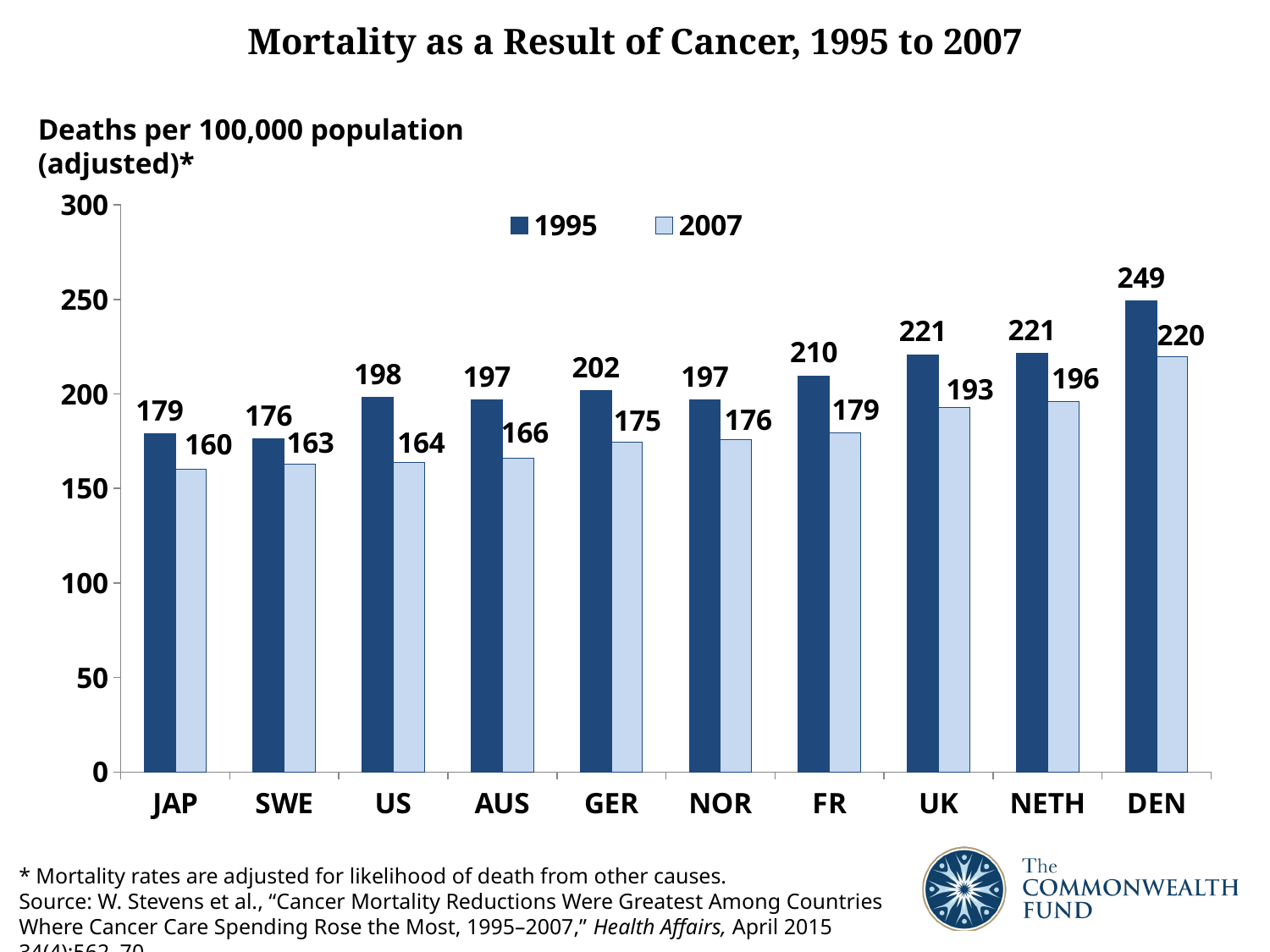
Which country had the highest cancer mortality rate in 1995? DEN Which is larger: the 2007 value for France (FR) or the 2007 value for Germany (GER)? FR What was the cancer mortality rate for Denmark (DEN) in 2007? 220 What unit is used for the values on the chart? Deaths per 100,000 population (adjusted) Which country had the lowest cancer mortality rate in 2007? JAP What is the difference between the 1995 values for Denmark (DEN) and Japan (JAP)? 70 What was the cancer mortality rate for the US in 1995? 198 By how much did the cancer mortality rate for the UK fall from 1995 to 2007? 28 How many series does the legend list? 2 How many countries are shown on the chart? 10 Is the 1995 value for Denmark (DEN) greater or less than 200? greater What type of chart is shown on the slide? Bar chart